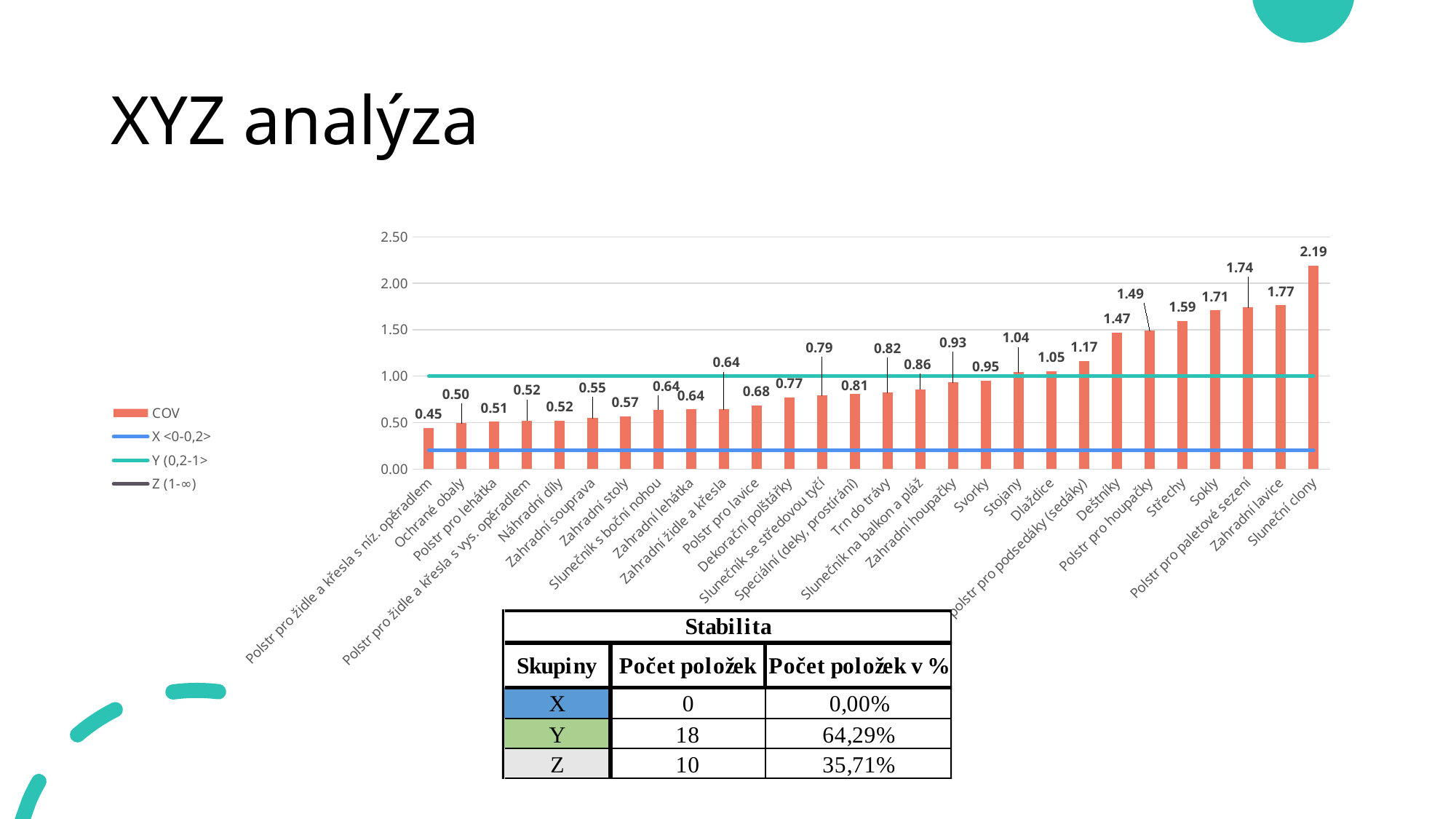
How many categories are shown on the x axis of the chart? 28 Which category has the highest COV value? Sluneční clony What is the difference between the COV values for Zahradní lavice and Sokly? 0.06 Do the COV values rise or fall from left to right along the x axis? rise Is the COV value for Střechy greater or less than 1.50? greater How many series does the chart legend list? 4 What is the COV value for Zahradní houpačky? 0.93 What kind of chart is used to show the COV values? bar chart Which has a higher COV value, Deštníky or Svorky? Deštníky Which category has the lowest COV value? Polstr pro židle a křesla s níz. opěradlem What is the COV value for Dlaždice? 1.05 What is the COV value for Sluneční clony? 2.19